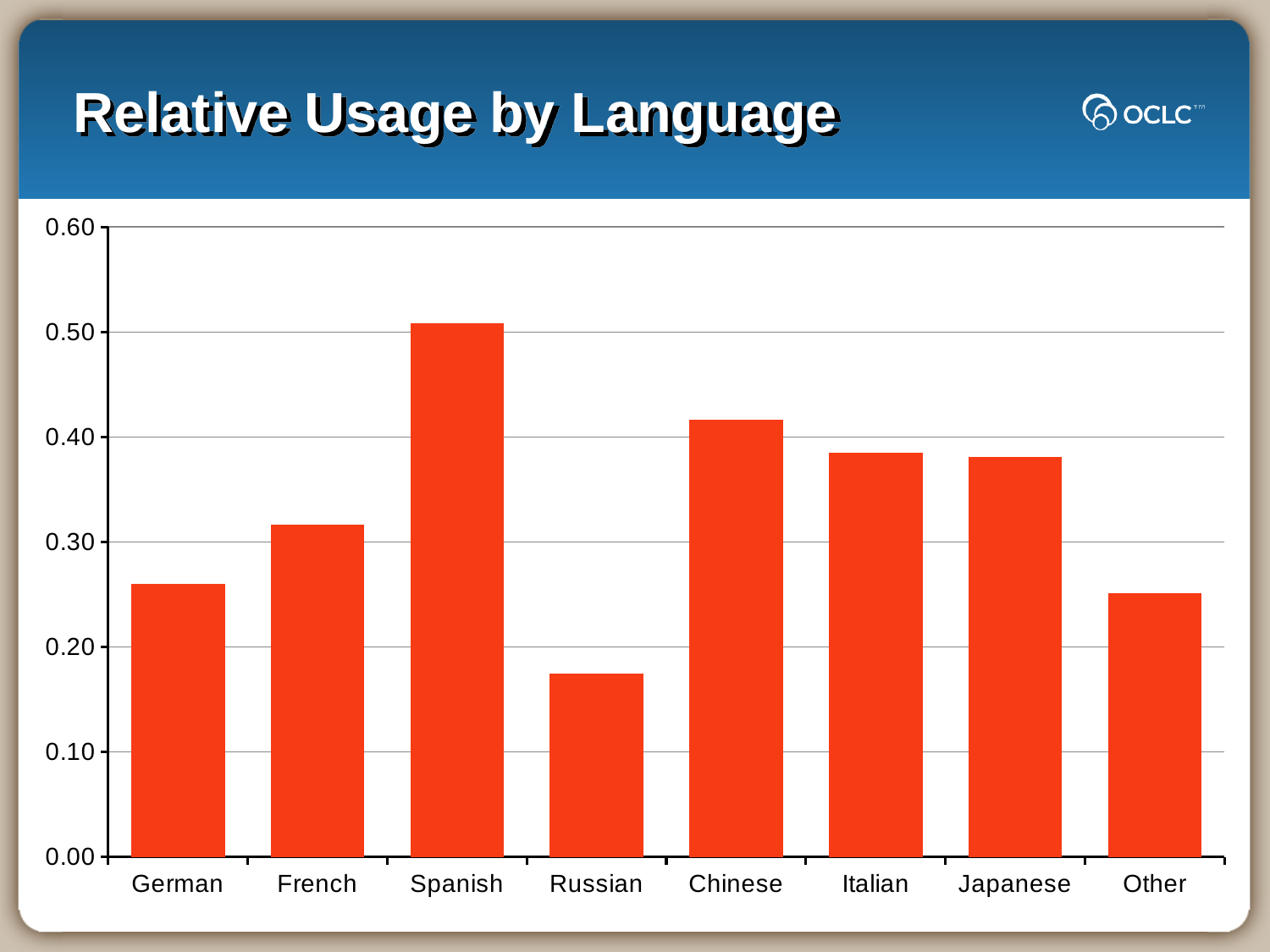
Is the value for Russian greater or less than 0.20? less Which language has the lowest relative usage? Russian Is the value for Spanish greater or less than 0.40? greater How many language categories are shown on the x axis? 8 Which is larger, the value for Chinese or the value for French? Chinese Is the value for German greater or less than 0.30? less What is the title of the chart? Relative Usage by Language Which is larger, the value for Russian or the value for Italian? Italian Which language has the highest relative usage? Spanish What kind of chart is shown on the slide? bar chart